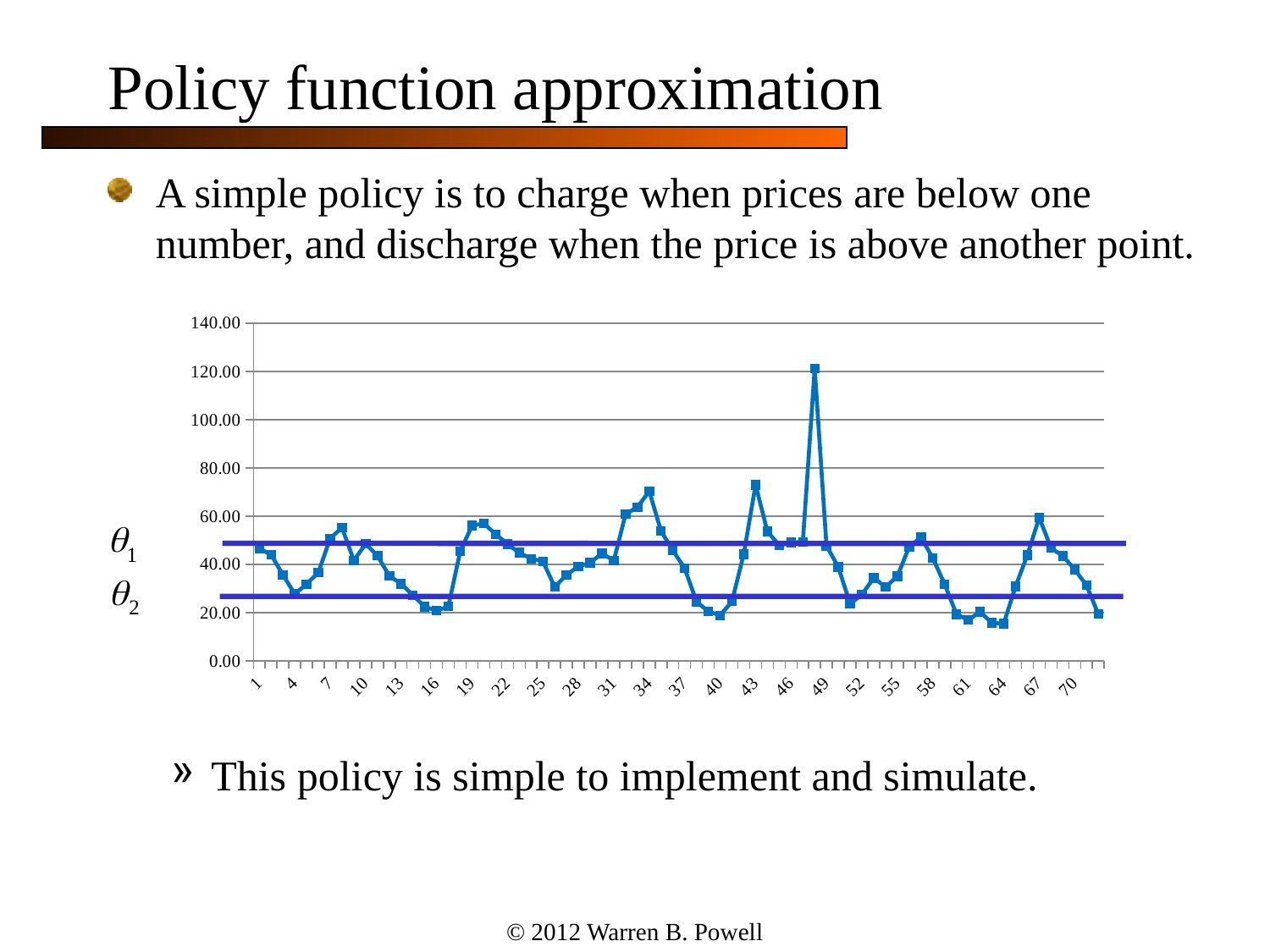
Is the value at x = 43 greater or less than 60.00? greater Which has the larger value, x = 49 or x = 34? 34 Is the value at x = 16 greater or less than 40.00? less Which has the larger value, x = 16 or x = 34? 34 How many horizontal reference lines (labelled θ1 and θ2) are drawn across the chart? 2 Is the value at x = 67 greater or less than 40.00? greater At which x-axis position does the line reach its highest value? 48 What is the highest value shown on the y axis? 140.00 What kind of chart is shown on the slide? line chart